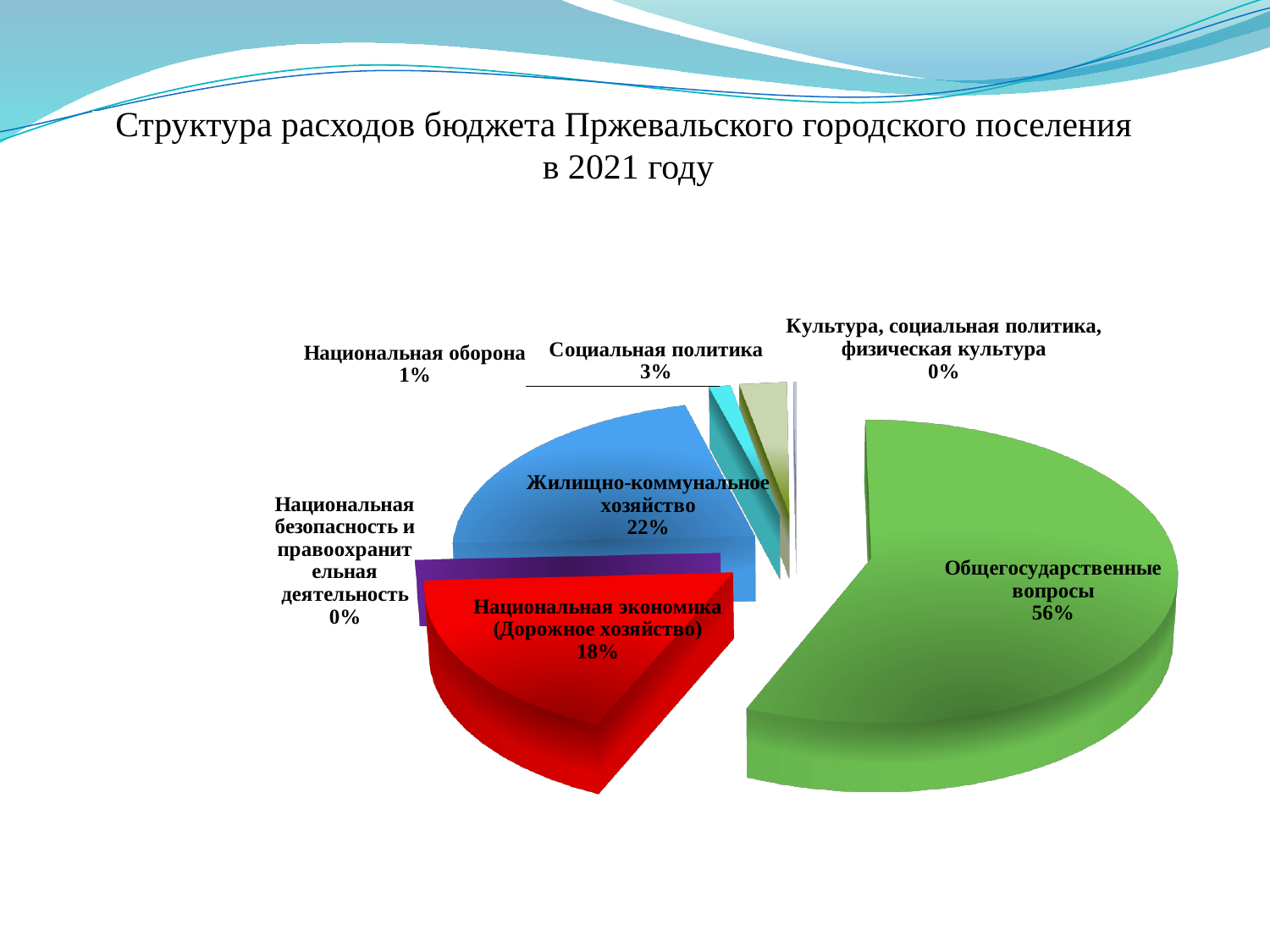
What share is shown for "Социальная политика"? 3% What share is shown for "Национальная экономика (Дорожное хозяйство)"? 18% Which category has the largest share of the budget expenditures? Общегосударственные вопросы What type of chart is shown on the slide? Pie chart How many categories are shown in the pie chart? 7 What share of the budget expenditures goes to "Общегосударственные вопросы"? 56% What share is shown for "Жилищно-коммунальное хозяйство"? 22% Which is larger: the share for "Жилищно-коммунальное хозяйство" or for "Национальная экономика (Дорожное хозяйство)"? Жилищно-коммунальное хозяйство What is the combined share of "Социальная политика" and "Национальная оборона"? 4% What share is shown for "Национальная оборона"? 1% What year does the chart title refer to? 2021 What is the difference in percentage points between "Общегосударственные вопросы" and "Жилищно-коммунальное хозяйство"? 34 percentage points